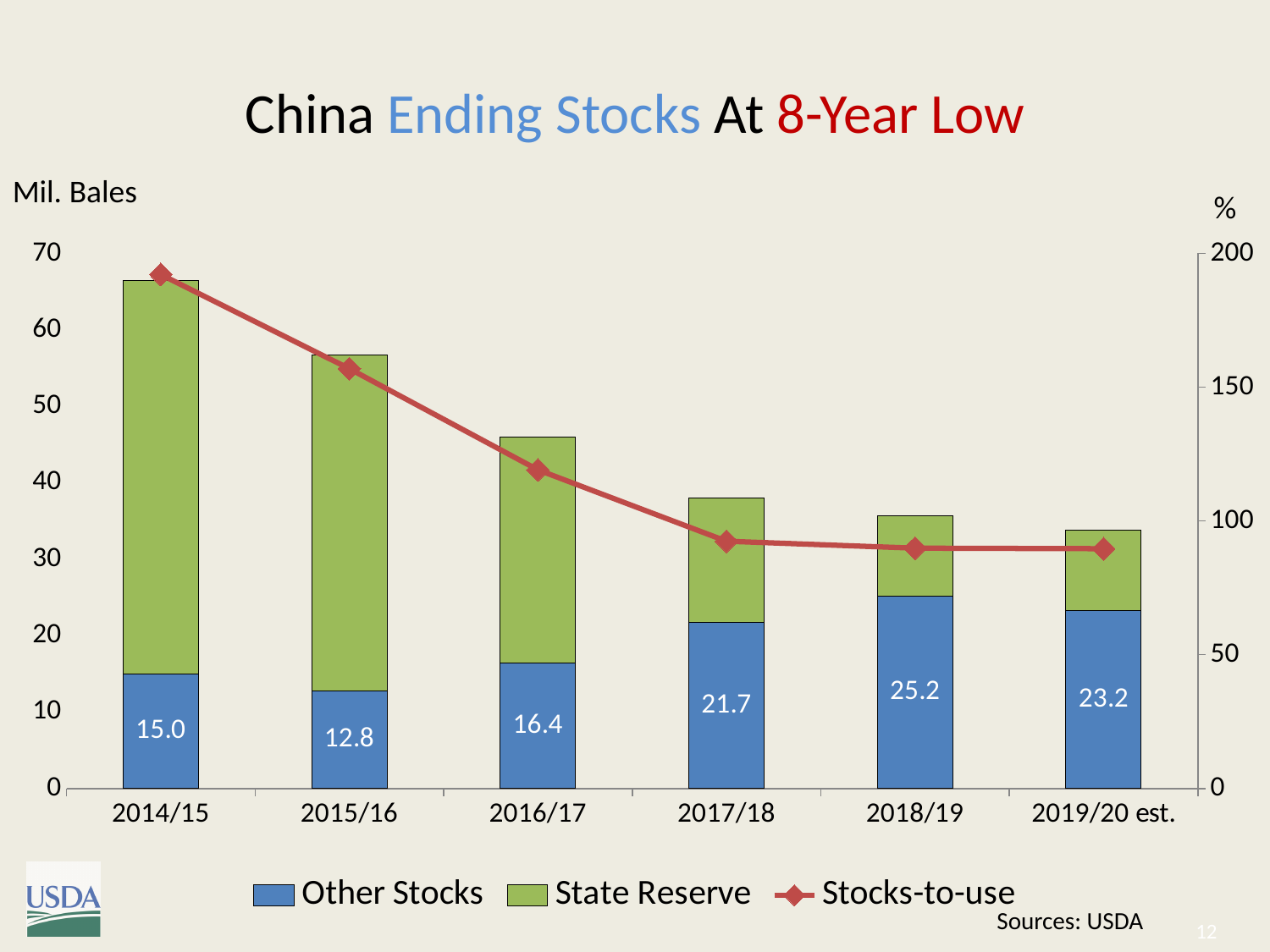
How many series does the legend list? 3 In which year is the Other Stocks value lowest? 2015/16 Which is larger, the Other Stocks value for 2019/20 est. or for 2017/18? 2019/20 est. What is the value of Other Stocks for 2014/15? 15.0 In which year is the Other Stocks value highest? 2018/19 Is the Stocks-to-use value for 2019/20 est. greater or less than 100%? less What is the difference between the Other Stocks values for 2018/19 and 2014/15? 10.2 What is the value of Other Stocks for 2019/20 est.? 23.2 How many years are shown on the x axis? 6 Is the total ending stocks bar for 2014/15 greater or less than 60 million bales? greater What is the value of Other Stocks for 2018/19? 25.2 Does the Stocks-to-use line rise or fall from 2014/15 to 2019/20 est.? fall